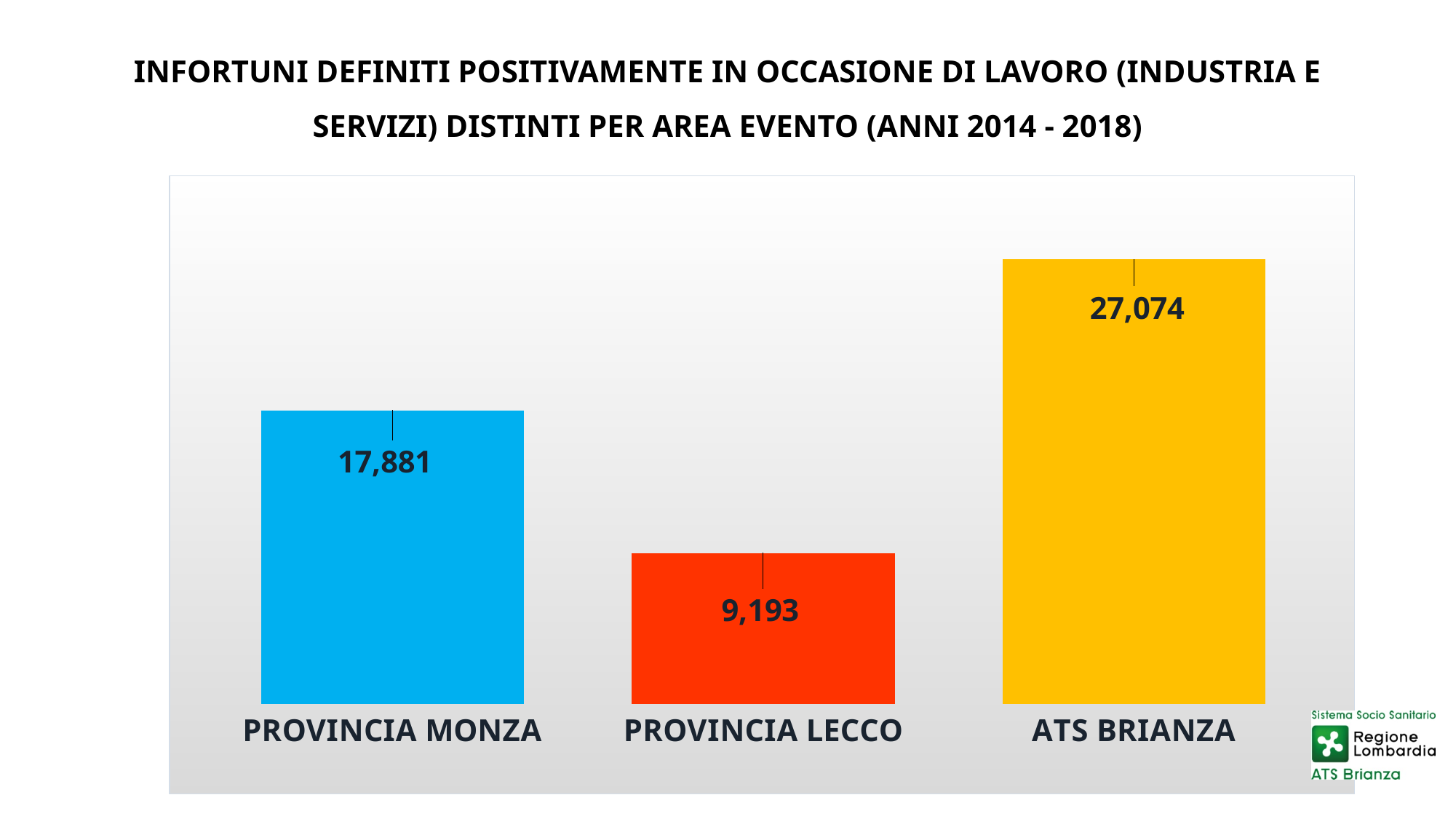
What is the value for ATS BRIANZA? 27,074 What is the value for PROVINCIA LECCO? 9,193 Which category has the lowest value? PROVINCIA LECCO What is the difference between the values for ATS BRIANZA and PROVINCIA MONZA? 9,193 Which category has the highest value? ATS BRIANZA What is the difference between the values for PROVINCIA MONZA and PROVINCIA LECCO? 8,688 What colour is the bar for ATS BRIANZA? Yellow What kind of chart is shown on the slide? Bar chart What is the value for PROVINCIA MONZA? 17,881 Which is larger, the value for PROVINCIA MONZA or the value for PROVINCIA LECCO? PROVINCIA MONZA What colour is the bar for PROVINCIA LECCO? Red How many categories are shown in the chart? 3